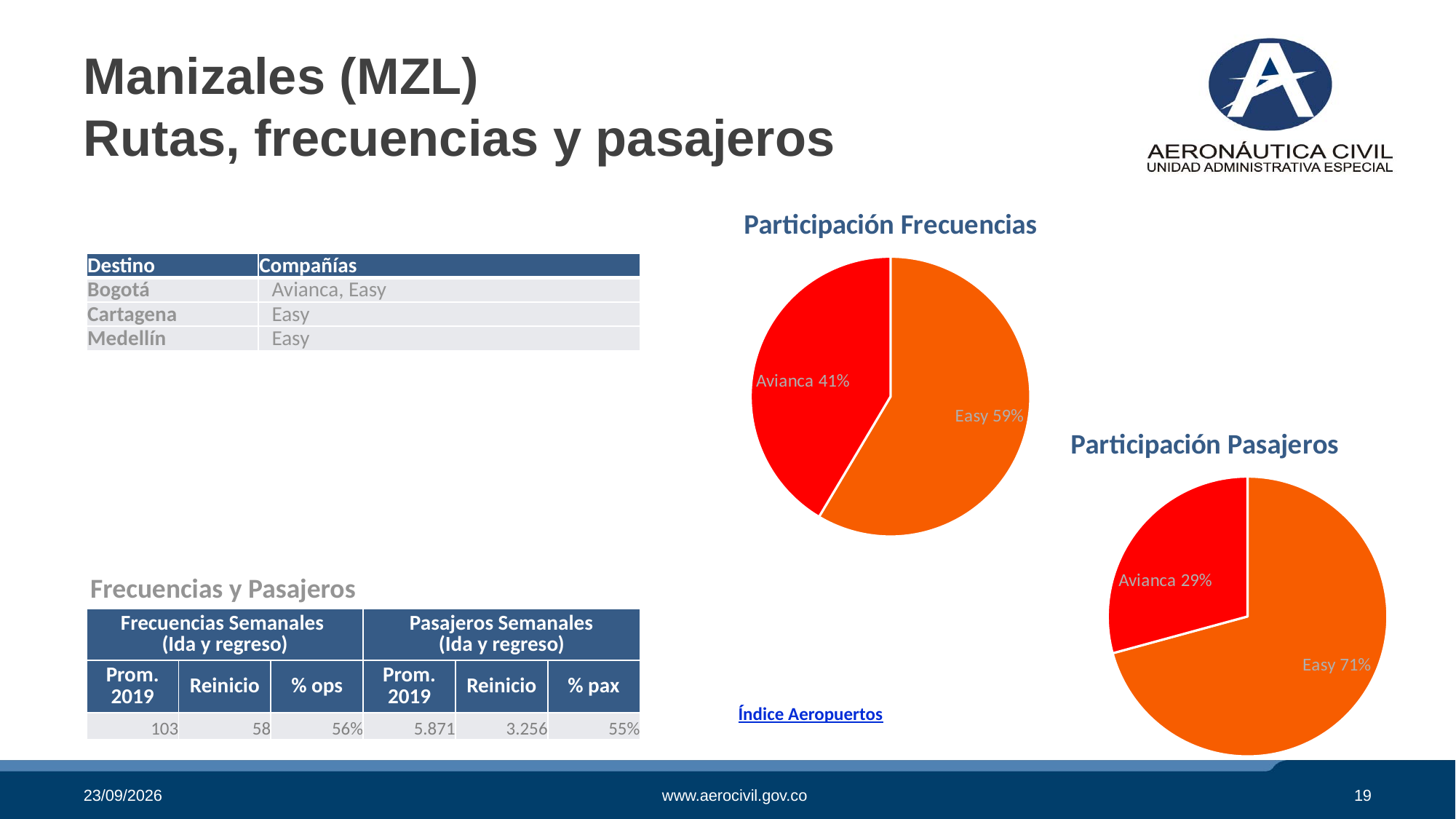
In the 'Participación Pasajeros' chart, what share does Easy have? 71% In the 'Participación Frecuencias' chart, what share does Avianca have? 41% In the 'Participación Frecuencias' chart, is Avianca's share larger or smaller than Easy's? smaller In the 'Participación Pasajeros' chart, what share does Avianca have? 29% In the 'Participación Frecuencias' chart, what is the difference in percentage points between Easy and Avianca? 18 How many slices does the 'Participación Frecuencias' pie chart have? 2 In the 'Participación Pasajeros' chart, what is the difference in percentage points between Easy and Avianca? 42 What kind of chart is 'Participación Pasajeros'? pie chart In the 'Participación Pasajeros' chart, what colour is the Easy slice? orange In the 'Participación Frecuencias' chart, which company has the largest slice? Easy In the 'Participación Pasajeros' chart, which company has the smallest slice? Avianca